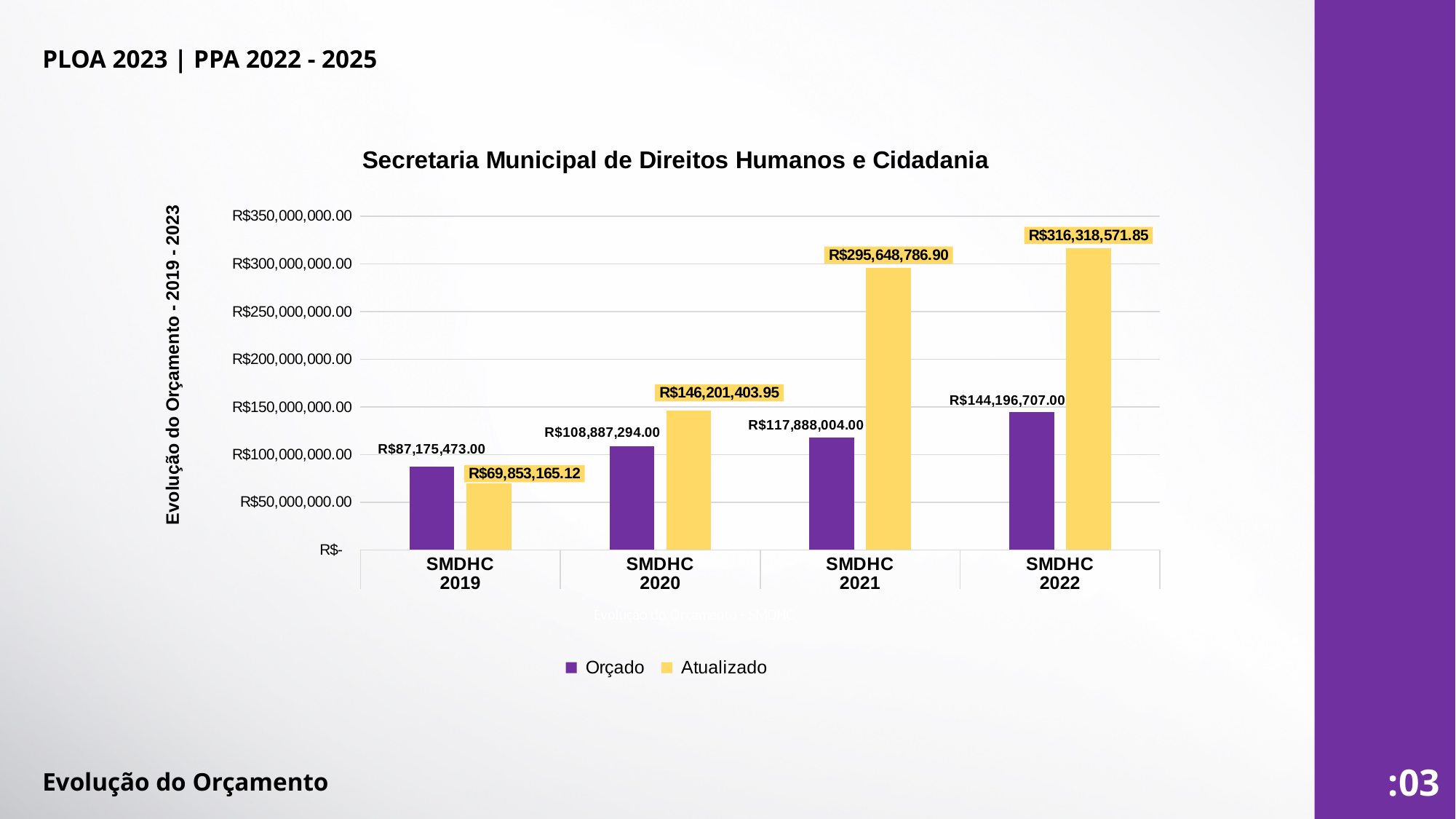
How many series does the legend list? 2 What kind of chart is shown on the slide? Bar chart What is the Atualizado value for SMDHC 2020? R$146,201,403.95 What is the difference between the Atualizado values for SMDHC 2022 and SMDHC 2021? R$20,669,784.95 What is the difference between the Orçado values for SMDHC 2022 and SMDHC 2019? R$57,021,234.00 For SMDHC 2019, which is larger, the Orçado or the Atualizado value? Orçado Which year has the lowest Orçado value? SMDHC 2019 What is the Orçado value for SMDHC 2022? R$144,196,707.00 What is the Atualizado value for SMDHC 2021? R$295,648,786.90 What is the Orçado value for SMDHC 2019? R$87,175,473.00 Do the Orçado values rise or fall from SMDHC 2019 to SMDHC 2022? Rise Which year has the highest Atualizado value? SMDHC 2022